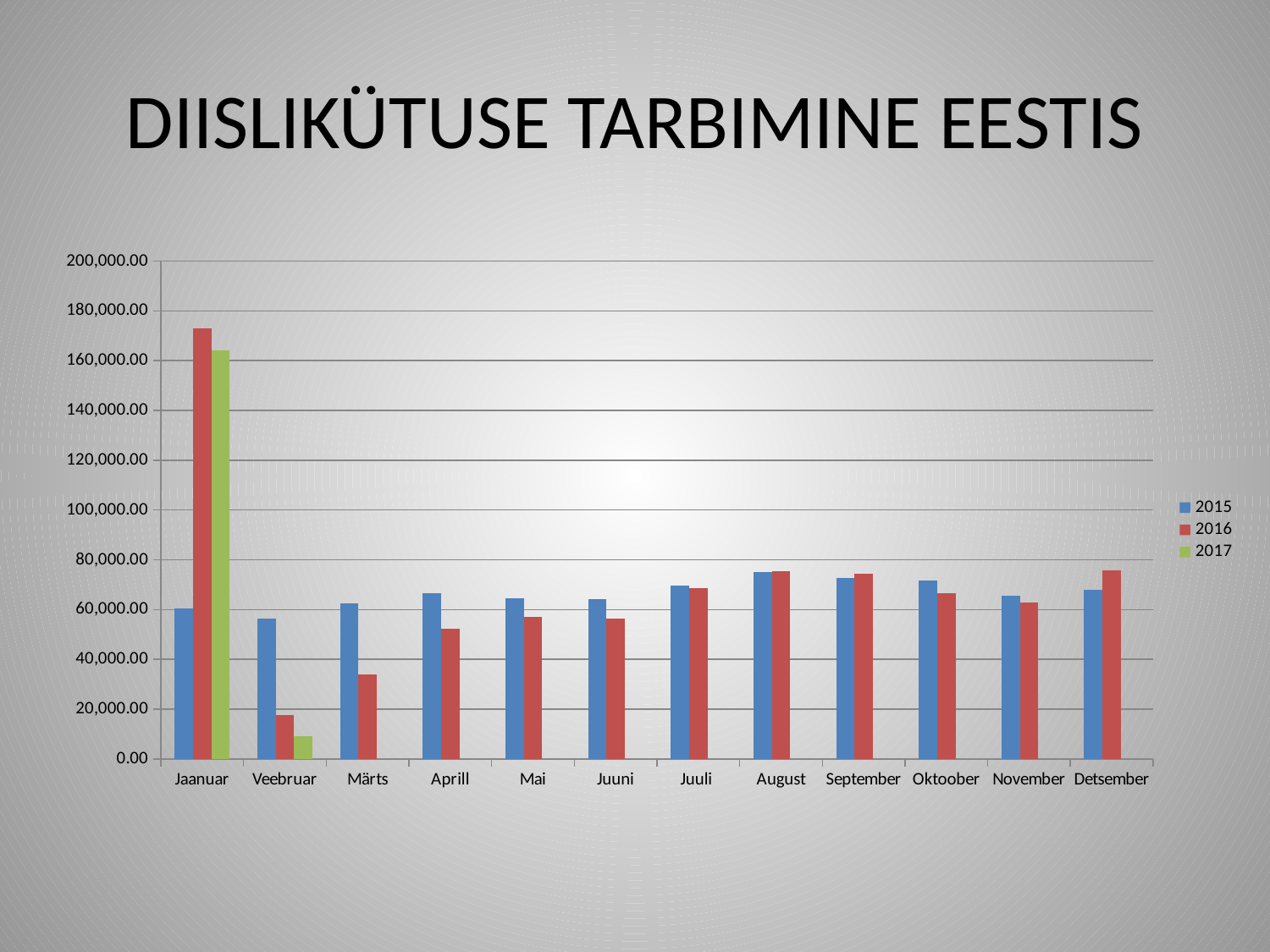
What kind of chart is shown on the slide? bar chart How many series does the legend list? 3 Which month has the highest value for 2016? Jaanuar Is the 2016 value for Jaanuar greater or less than 160,000.00? greater In Jaanuar, which is larger: the 2016 value or the 2017 value? 2016 Is the 2015 value for Jaanuar greater or less than 80,000.00? less For how many months is a 2017 bar plotted? 2 Is the 2016 value for Veebruar greater or less than 20,000.00? less Which month has the lowest value for 2016? Veebruar How many months are shown along the x axis? 12 Which month has the lowest value for 2015? Veebruar In Aprill, which is larger: the 2015 value or the 2016 value? 2015